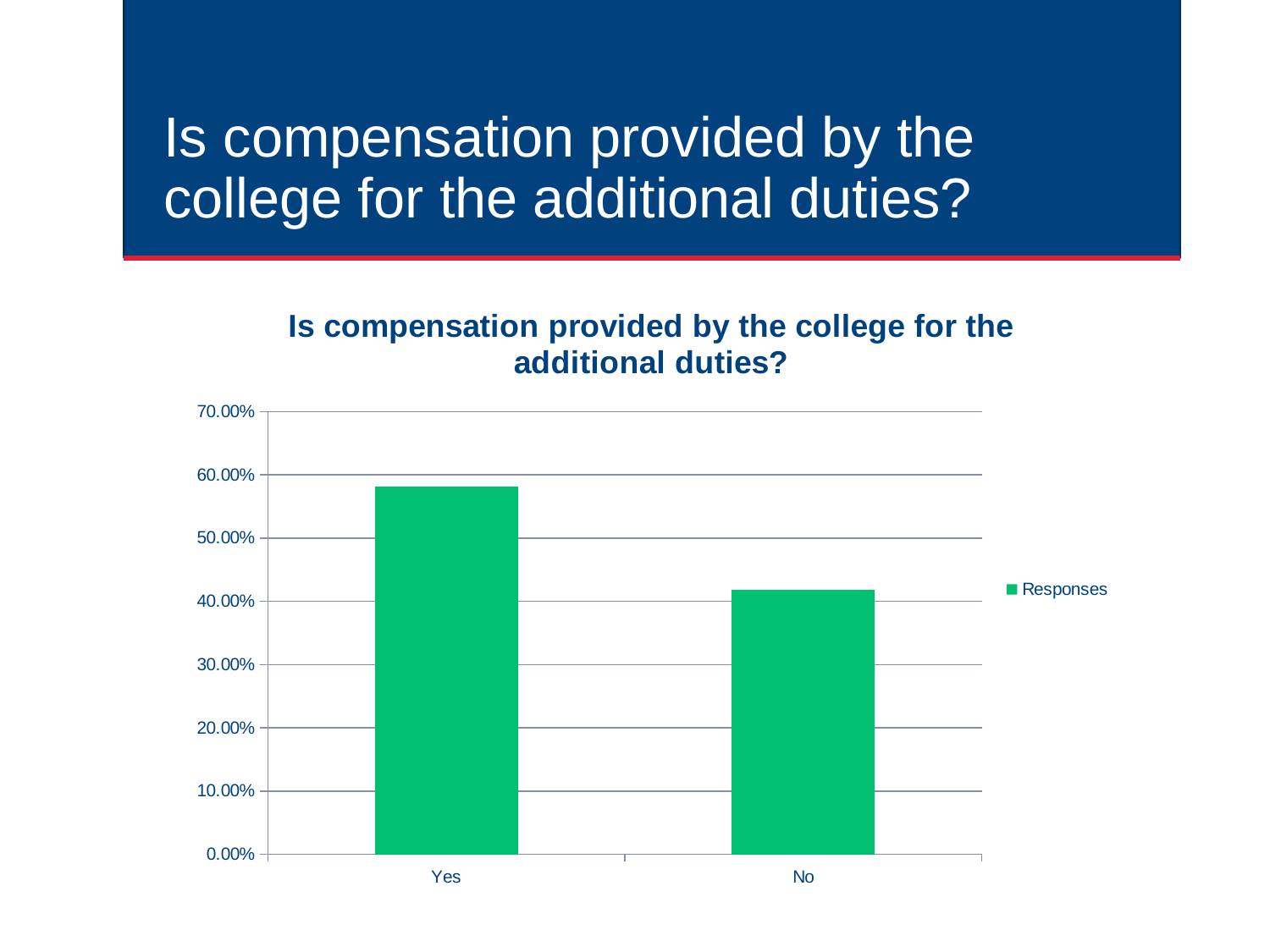
What is the title of the chart? Is compensation provided by the college for the additional duties? Which category has the lowest value? No How many categories are shown on the x axis of the chart? 2 Which is larger, the value for Yes or the value for No? Yes What is the name of the series listed in the legend? Responses Is the value for Yes greater or less than 60.00%? less Which category has the highest value? Yes Is the value for No greater or less than 40.00%? greater What kind of chart is shown on the slide? bar chart Is the value for Yes greater or less than 50.00%? greater How many series does the legend list? 1